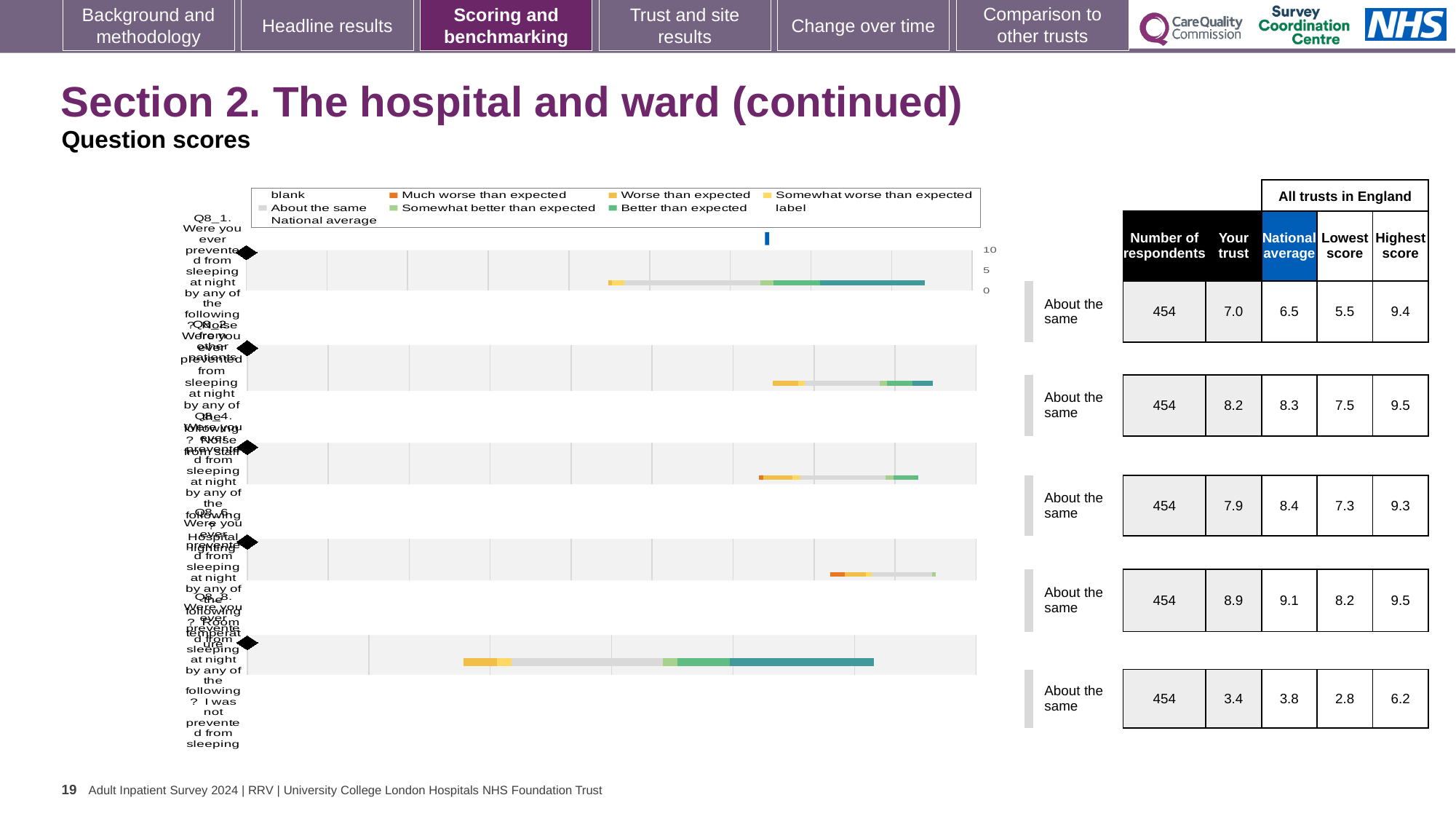
What is the highest tick value shown on the chart's x axis? 10 For the first row (Q8_1), how much higher is the 'Your trust' score than the national average? 0.5 Which row has the lowest 'Your trust' score in the table beside the chart? Q8_8 (I was not prevented from sleeping), 3.4 How many respondents are listed for each question row in the table? 454 How many question rows (bars) does the chart show? 5 What benchmark label is shown next to every bar in the chart? About the same Which row has the highest 'Your trust' score in the table beside the chart? Q8_6 (room temperature), 8.9 What is the highest score across all trusts in England for the last row (Q8_8)? 6.2 In the table beside the chart, what is the 'Your trust' score for the first row (Q8_1, noise from other patients)? 7.0 What kind of chart is shown on the slide? bar chart For the third row (Q8_4, hospital lighting), which is larger: the 'Your trust' score or the national average? National average (8.4 vs 7.9) In the table beside the chart, what is the national average for the last row (Q8_8, I was not prevented from sleeping)? 3.8